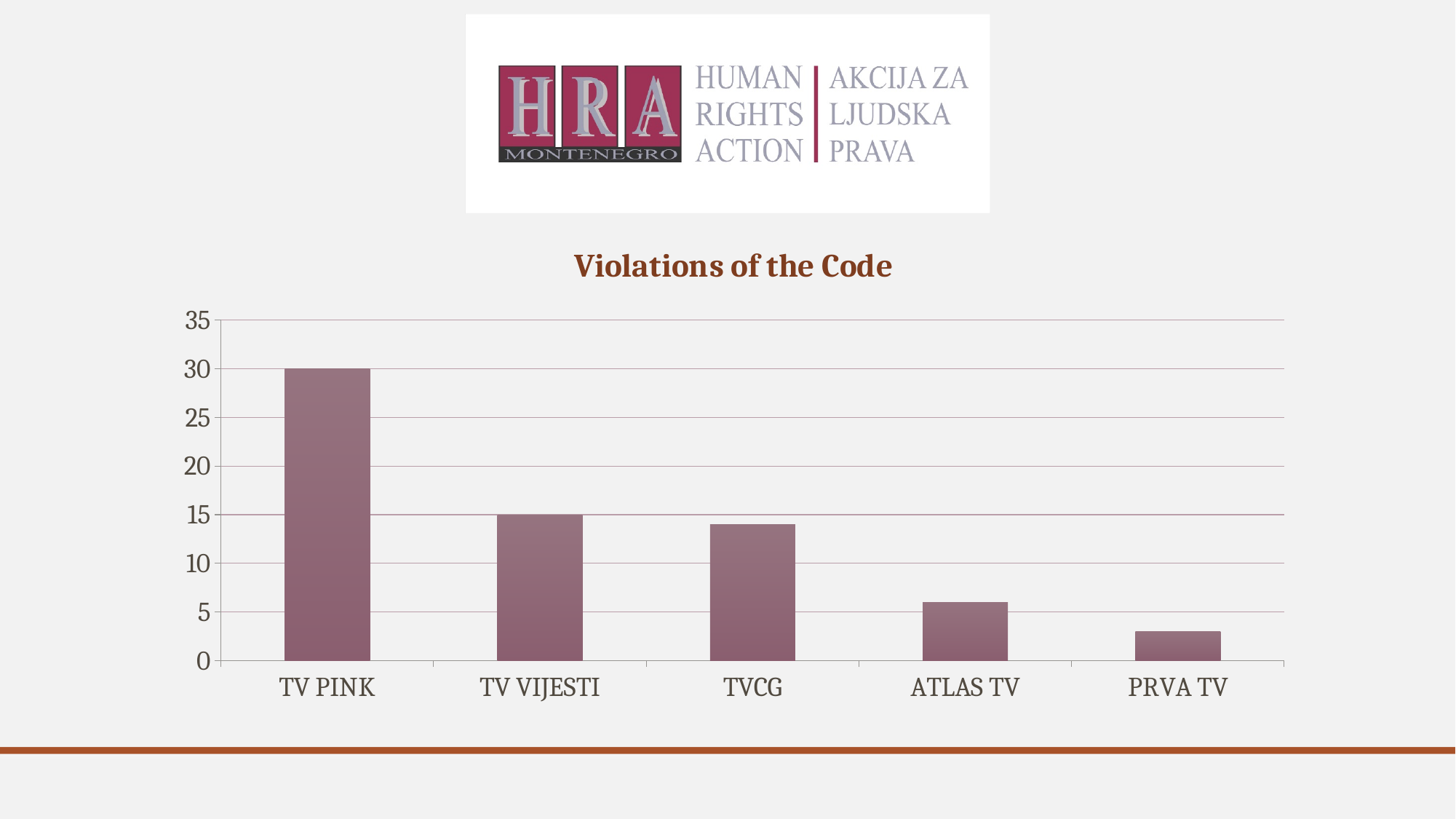
What kind of chart is shown on the slide? bar chart How many TV stations are shown on the x axis of the chart? 5 What is the value for TV PINK? 30 Is the value for PRVA TV greater or less than 5? less What is the value for TV VIJESTI? 15 Do the values rise or fall from left to right along the x axis? fall Which TV station has the highest number of violations? TV PINK Which TV station has the lowest number of violations? PRVA TV What is the difference between the values for TV PINK and TV VIJESTI? 15 Is the value for ATLAS TV greater or less than 5? greater Is the value for TVCG greater or less than 15? less What is the title of the chart? Violations of the Code